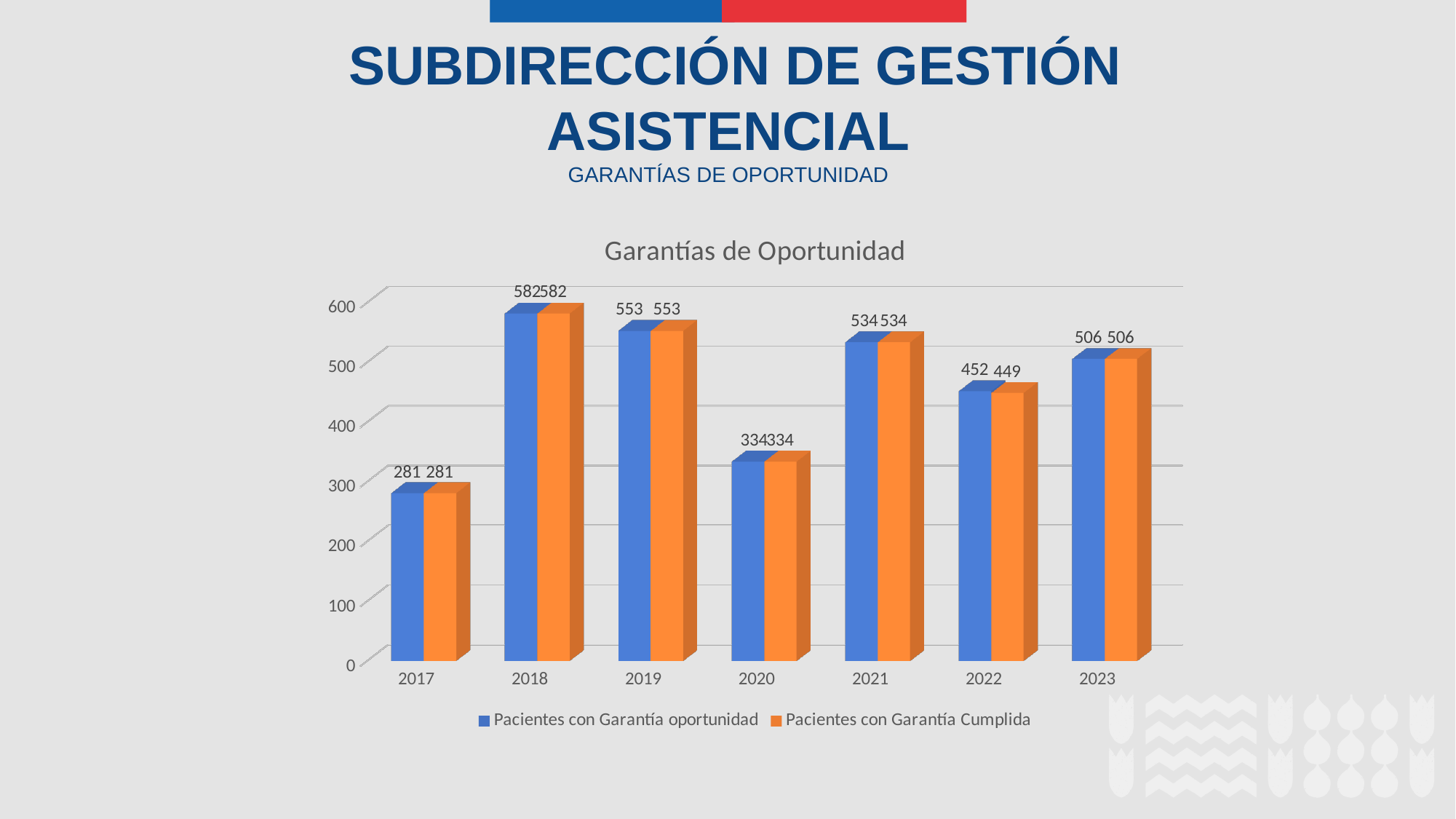
What is the difference between the Pacientes con Garantía oportunidad values for 2018 and 2017? 301 Which is larger: Pacientes con Garantía oportunidad in 2019 or in 2021? 2019 What is the title of the chart? Garantías de Oportunidad Which year has the lowest value for Pacientes con Garantía Cumplida? 2017 What is the value for Pacientes con Garantía oportunidad in 2018? 582 What kind of chart is shown on the slide? Bar chart What is the value for Pacientes con Garantía Cumplida in 2022? 449 What is the difference between Pacientes con Garantía oportunidad and Pacientes con Garantía Cumplida in 2022? 3 How many years are shown on the x axis? 7 What is the value for Pacientes con Garantía oportunidad in 2020? 334 Which year has the highest value for Pacientes con Garantía oportunidad? 2018 How many series does the legend list? 2